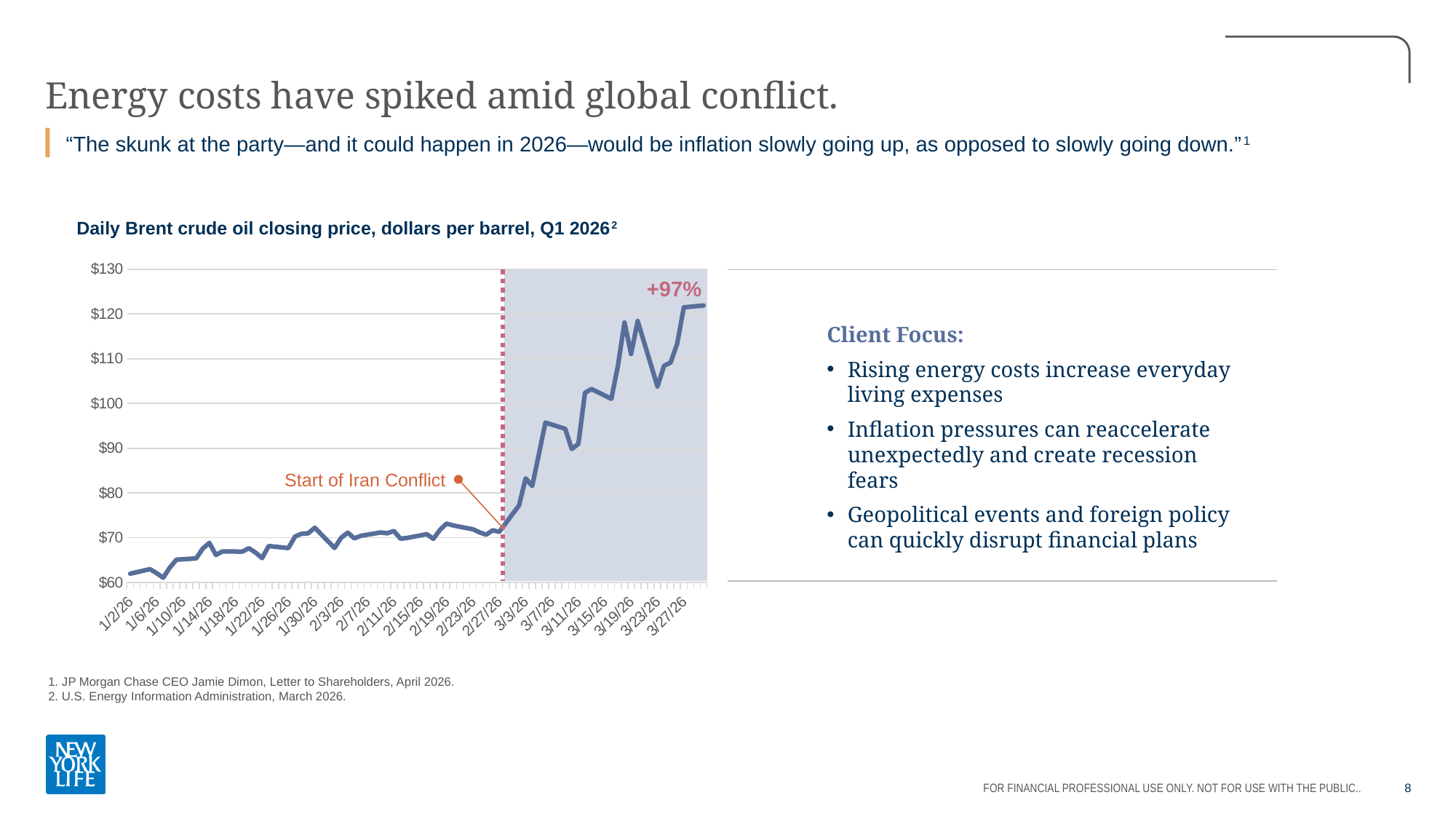
Is the value for 3/27/26 greater or less than $110? greater Is the value at the start of the Iran conflict (2/27/26) greater or less than $80? less How many lines (series) are plotted on the chart? 1 What percentage change is labeled in the shaded area of the chart? +97% What event does the annotation on the chart mark? Start of Iran Conflict Does the Brent crude oil price rise or fall overall from 1/2/26 to 3/27/26? rise What is the highest value shown on the y axis? $130 Is the value for 3/7/26 greater or less than $90? greater What kind of chart is shown on the slide? Line chart What is the title of the chart? Daily Brent crude oil closing price, dollars per barrel, Q1 2026 Which is higher, the price on 3/27/26 or the price on 1/2/26? 3/27/26